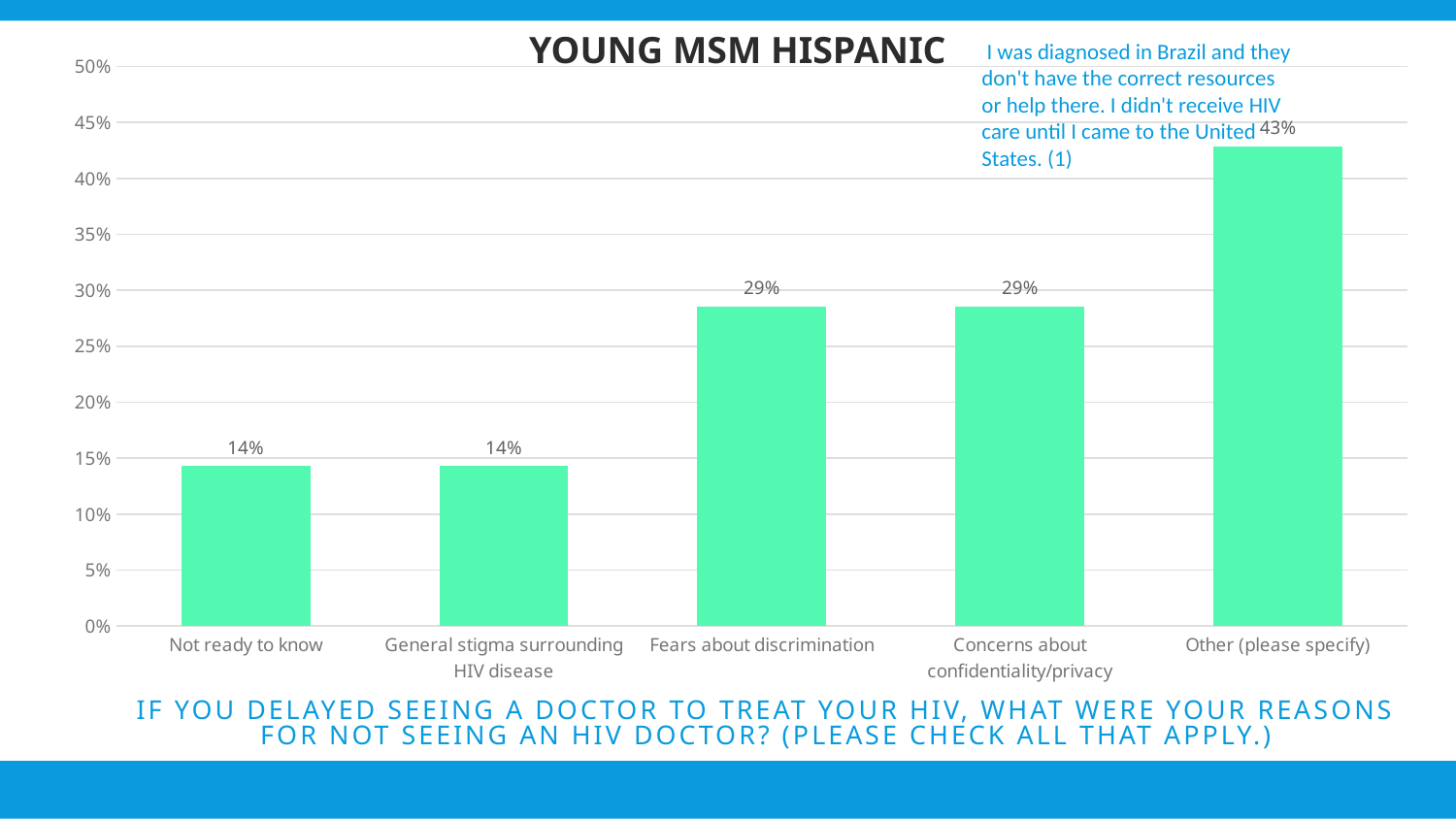
What kind of chart is shown? Bar chart What is the difference between "Other (please specify)" and "Concerns about confidentiality/privacy"? 14% What is the difference between "Fears about discrimination" and "General stigma surrounding HIV disease"? 15% How many categories are shown on the x axis? 5 What is the title of the chart? YOUNG MSM HISPANIC What is the value for "Not ready to know"? 14% What is the value for "Fears about discrimination"? 29% Is the value for "General stigma surrounding HIV disease" greater or less than 20%? less Is the value for "Other (please specify)" greater or less than 40%? greater Which category has the highest value? Other (please specify) What is the value for "Other (please specify)"? 43% Which is larger, "Concerns about confidentiality/privacy" or "Not ready to know"? Concerns about confidentiality/privacy